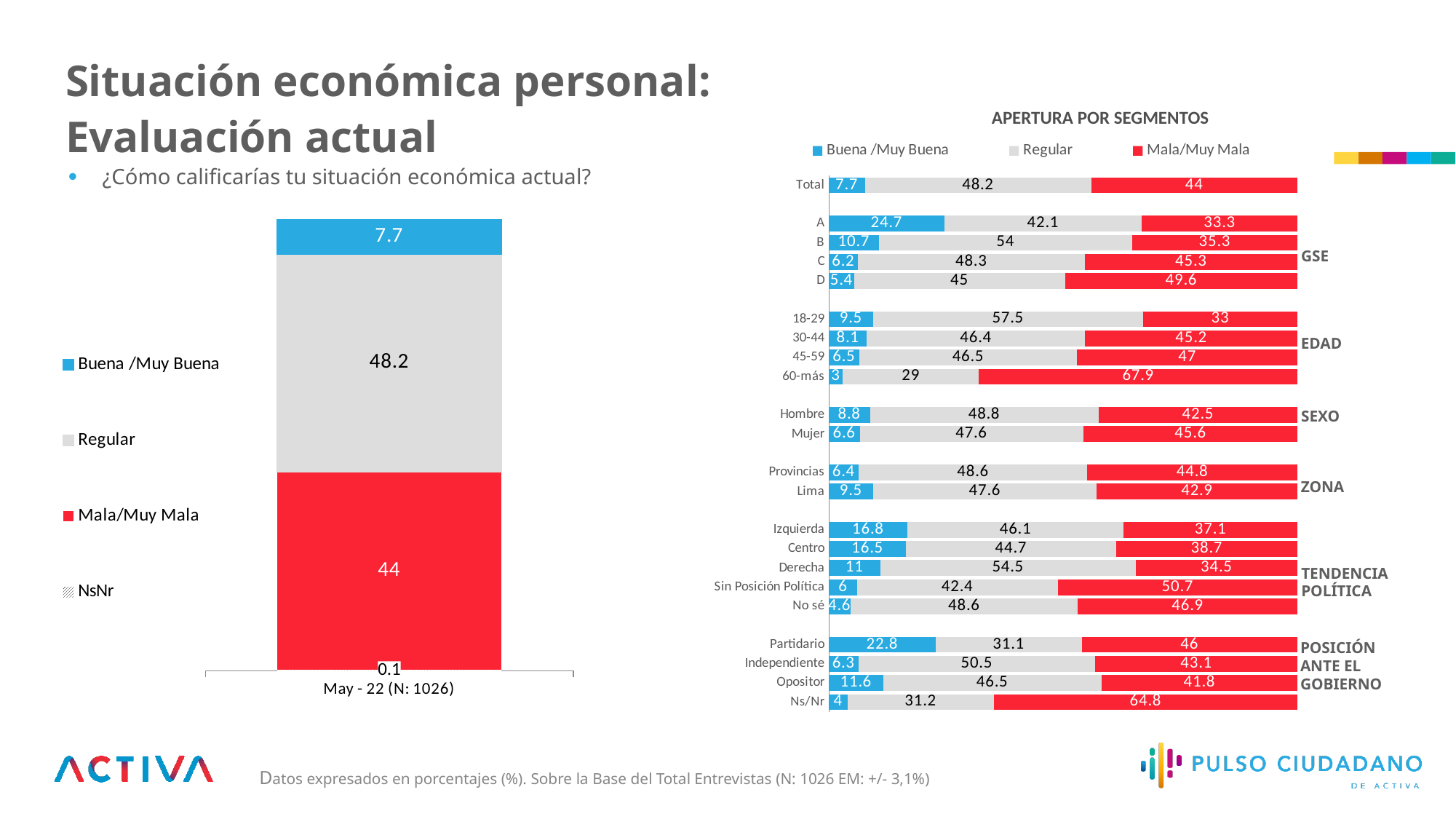
In the APERTURA POR SEGMENTOS chart, how many series does the legend list? 3 In the left stacked bar chart (May - 22), what is the value for Mala/Muy Mala? 44 In the APERTURA POR SEGMENTOS chart, which has a larger Buena /Muy Buena value, Partidario or Opositor? Partidario What kind of chart is the APERTURA POR SEGMENTOS chart? Stacked bar chart In the APERTURA POR SEGMENTOS chart, what is the Buena /Muy Buena value for segment A? 24.7 In the APERTURA POR SEGMENTOS chart, what is the Mala/Muy Mala value for 60-más? 67.9 In the APERTURA POR SEGMENTOS chart, what is the Regular value for Derecha? 54.5 In the APERTURA POR SEGMENTOS chart, what is the difference between the Mala/Muy Mala values for Hombre and Mujer? 3.1 In the left stacked bar chart (May - 22), how many series does the legend list? 4 In the APERTURA POR SEGMENTOS chart, which segment has the lowest Buena /Muy Buena value? 60-más In the APERTURA POR SEGMENTOS chart, which segment has the highest Mala/Muy Mala value? 60-más In the left stacked bar chart (May - 22), what is the value for Regular? 48.2